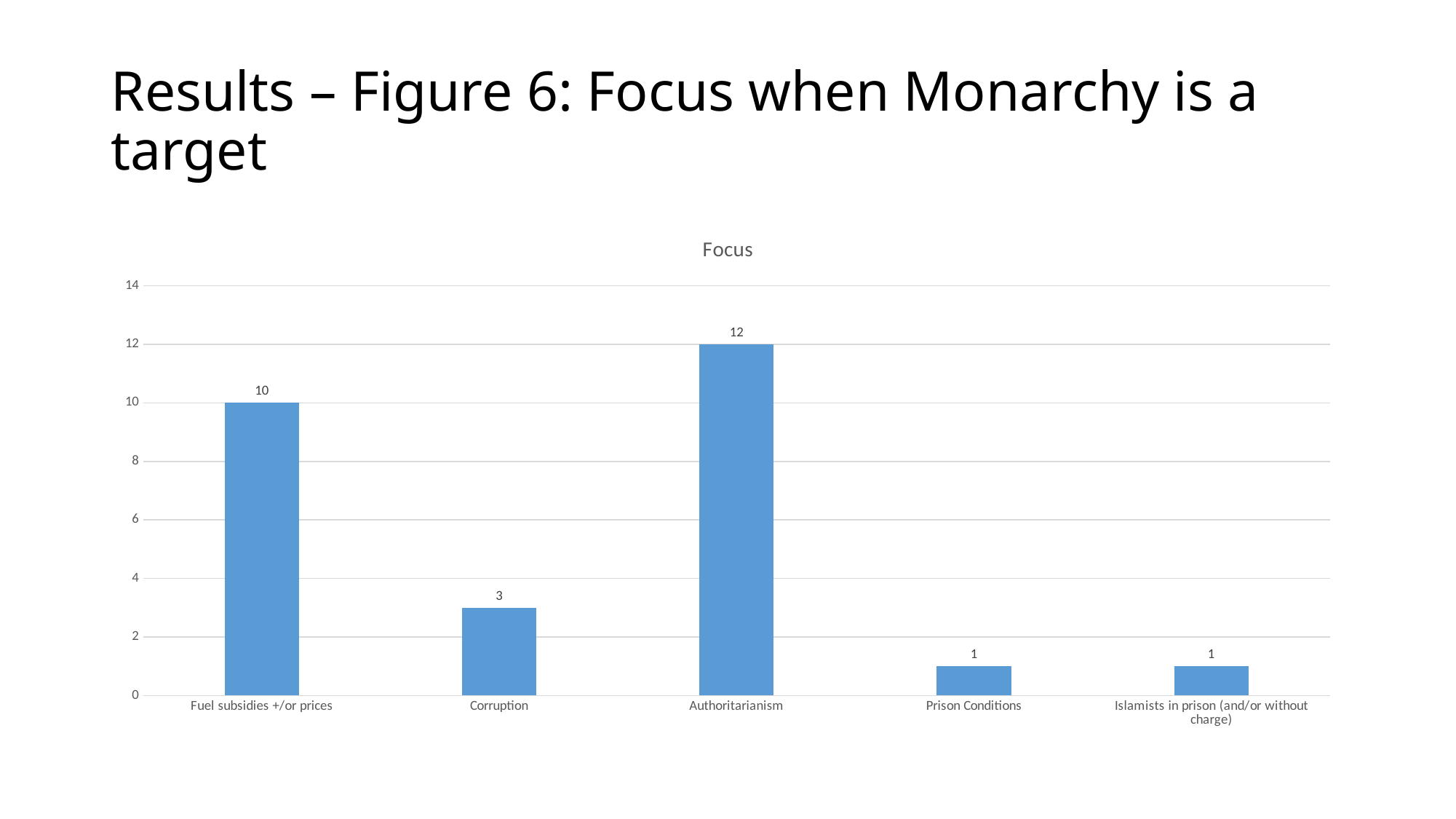
How many categories are shown on the x axis? 5 What is the value for Fuel subsidies +/or prices? 10 What is the title of the chart? Focus What is the value for Prison Conditions? 1 What is the value for Corruption? 3 Which category has the highest value? Authoritarianism Is the value for Authoritarianism greater or less than 10? greater What is the difference between the values for Fuel subsidies +/or prices and Corruption? 7 What is the difference between the values for Authoritarianism and Fuel subsidies +/or prices? 2 What kind of chart is shown on the slide? bar chart What is the value for Authoritarianism? 12 Which is larger, the value for Corruption or the value for Prison Conditions? Corruption